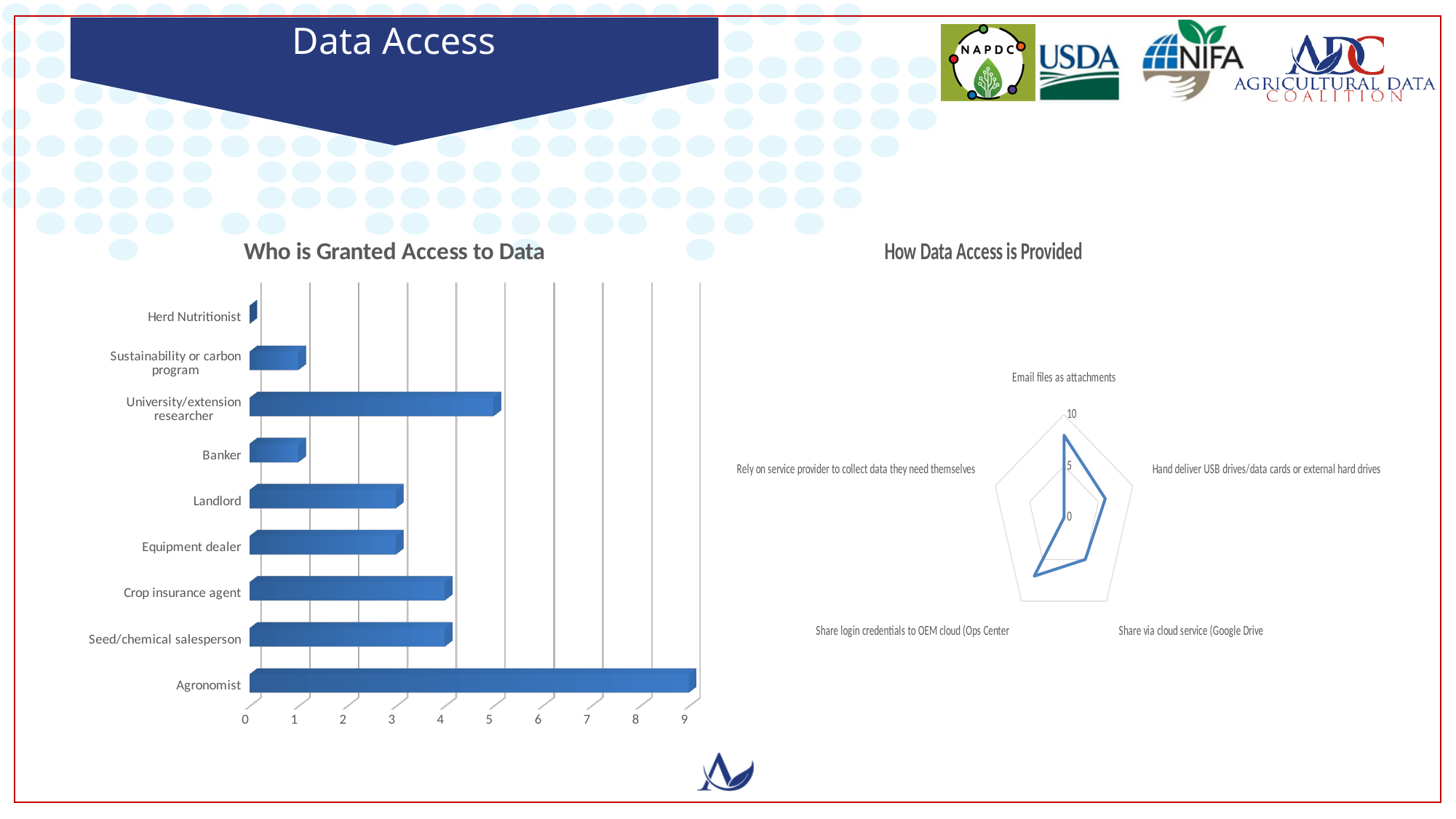
On the 'Who is Granted Access to Data' chart, which category has the highest value? Agronomist On the 'Who is Granted Access to Data' chart, which category has the lowest value? Herd Nutritionist On the 'Who is Granted Access to Data' chart, is the value for Herd Nutritionist greater or less than 1? less On the 'How Data Access is Provided' chart, how many categories are plotted? 5 On the 'How Data Access is Provided' chart, what kind of chart is shown? radar chart On the 'Who is Granted Access to Data' chart, how many categories are plotted? 9 On the 'Who is Granted Access to Data' chart, is the value for Agronomist greater or less than 8? greater On the 'Who is Granted Access to Data' chart, what kind of chart is shown? bar chart On the 'How Data Access is Provided' chart, is the value for 'Email files as attachments' greater or less than 5? greater On the 'Who is Granted Access to Data' chart, which is larger: University/extension researcher or Landlord? University/extension researcher On the 'Who is Granted Access to Data' chart, which is larger: Banker or Crop insurance agent? Crop insurance agent